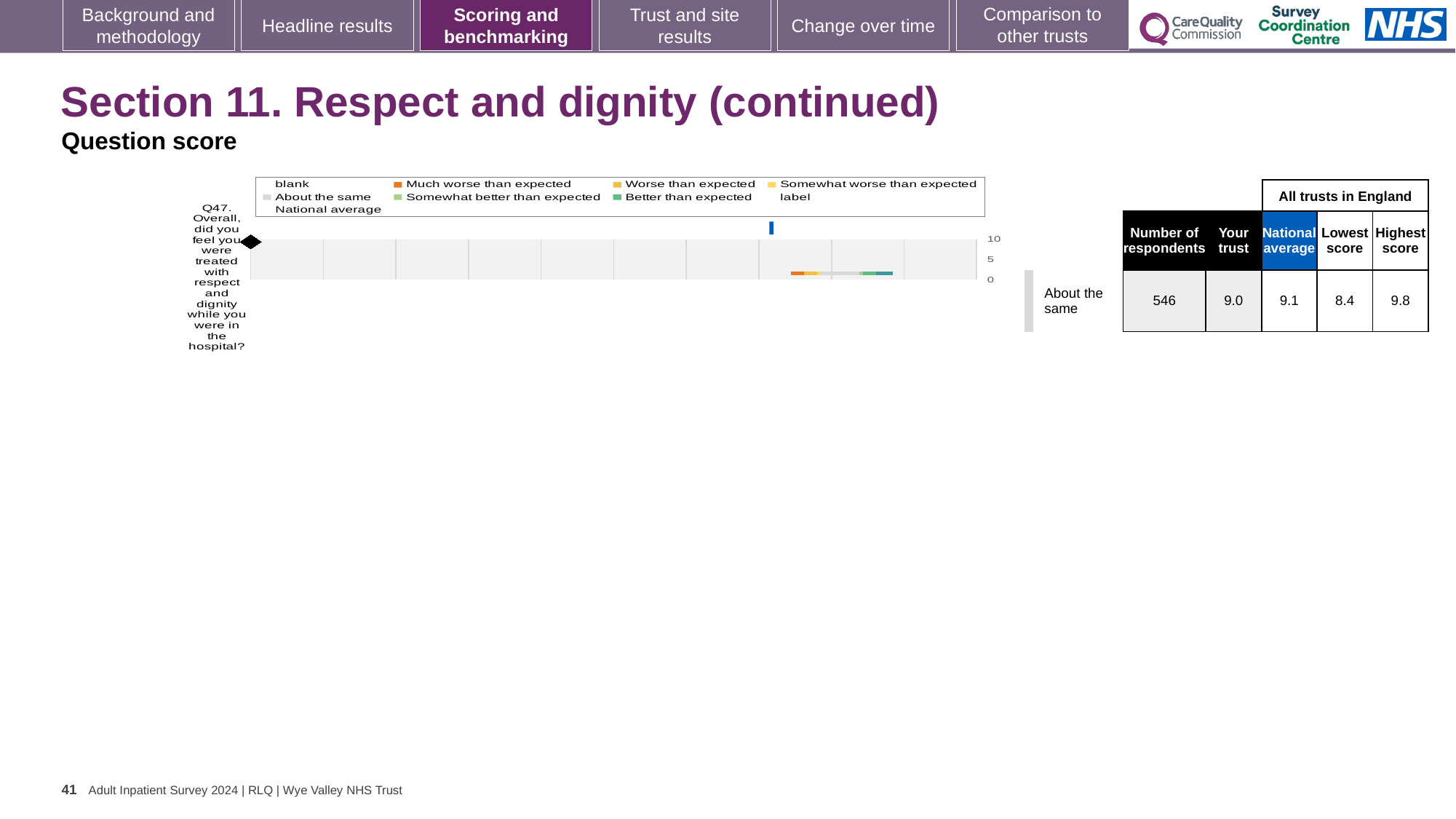
How many entries does the chart legend list? 9 What is the lowest score among all trusts in England for Q47? 8.4 What is the 'Your trust' score for Q47 shown next to the chart? 9.0 What is the highest value shown on the chart's axis? 10 What is the number of respondents for Q47? 546 Which question is plotted on the chart? Q47. Overall, did you feel you were treated with respect and dignity while you were in the hospital? Which is larger for Q47, the 'Your trust' score or the national average? National average How many questions (categories) are plotted on the chart? 1 What is the difference between the highest score and the lowest score among all trusts in England for Q47? 1.4 What is the national average score for Q47 shown next to the chart? 9.1 What is the highest score among all trusts in England for Q47? 9.8 What kind of chart is shown on the slide? bar chart